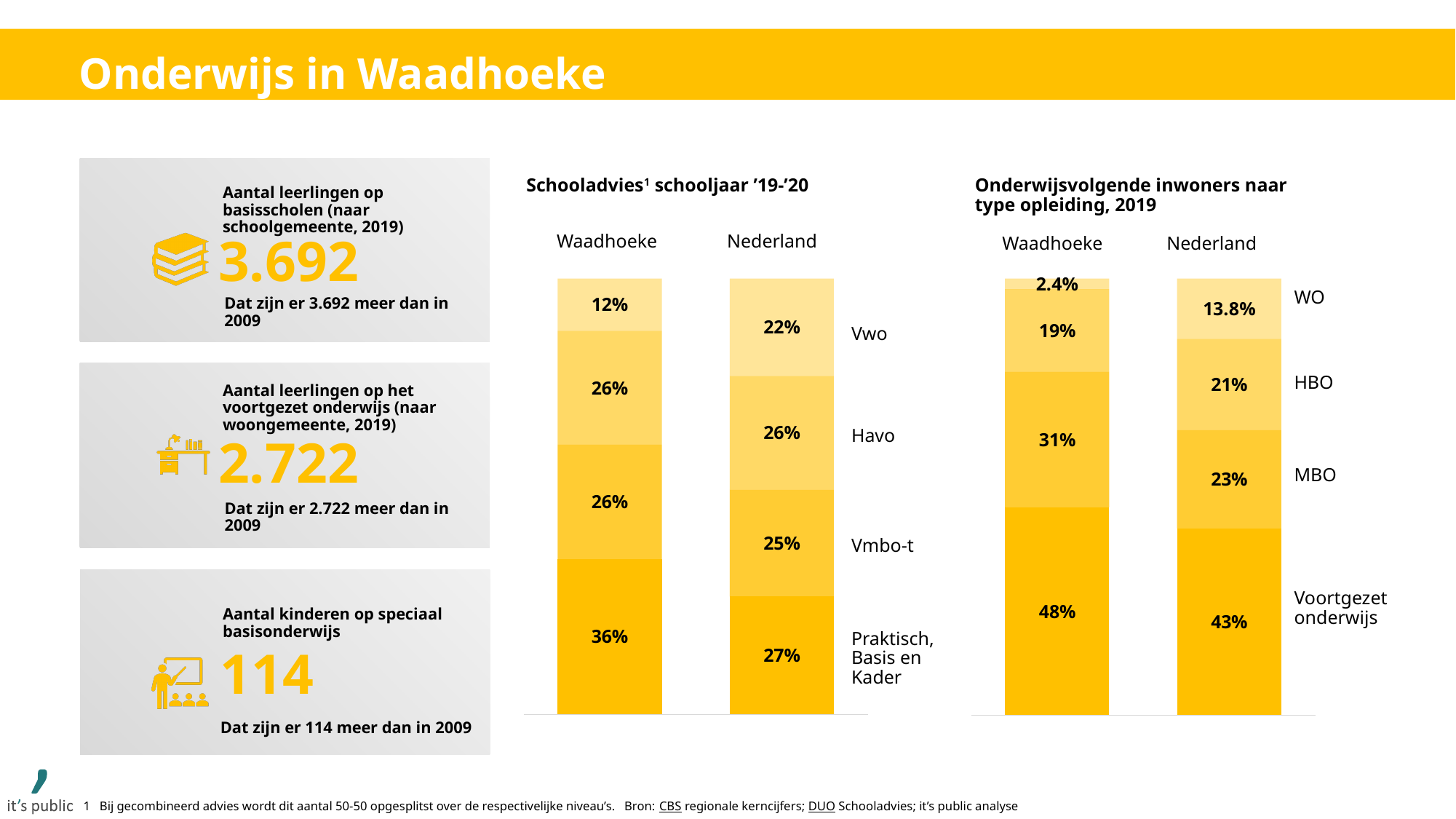
In the 'Schooladvies schooljaar '19-'20' chart, which segment is the largest in the Waadhoeke bar? Praktisch, Basis en Kader In the 'Onderwijsvolgende inwoners naar type opleiding, 2019' chart, what is the WO share for Waadhoeke? 2.4% In the 'Onderwijsvolgende inwoners naar type opleiding, 2019' chart, which has a larger WO share, Waadhoeke or Nederland? Nederland In the 'Schooladvies schooljaar '19-'20' chart, what is the Praktisch, Basis en Kader share for Nederland? 27% In the 'Onderwijsvolgende inwoners naar type opleiding, 2019' chart, what is the HBO share for Nederland? 21% In the 'Onderwijsvolgende inwoners naar type opleiding, 2019' chart, which segment is the smallest in the Waadhoeke bar? WO What kind of chart is the 'Schooladvies schooljaar '19-'20' chart? Stacked bar chart How many segments make up each bar in the 'Onderwijsvolgende inwoners naar type opleiding, 2019' chart? 4 In the 'Schooladvies schooljaar '19-'20' chart, what is the difference between the Vwo share for Nederland and for Waadhoeke? 10% In the 'Schooladvies schooljaar '19-'20' chart, which has a larger Praktisch, Basis en Kader share, Waadhoeke or Nederland? Waadhoeke In the 'Onderwijsvolgende inwoners naar type opleiding, 2019' chart, what is the difference between the MBO share for Waadhoeke and for Nederland? 8% In the 'Schooladvies schooljaar '19-'20' chart, what is the Vwo share for Waadhoeke? 12%